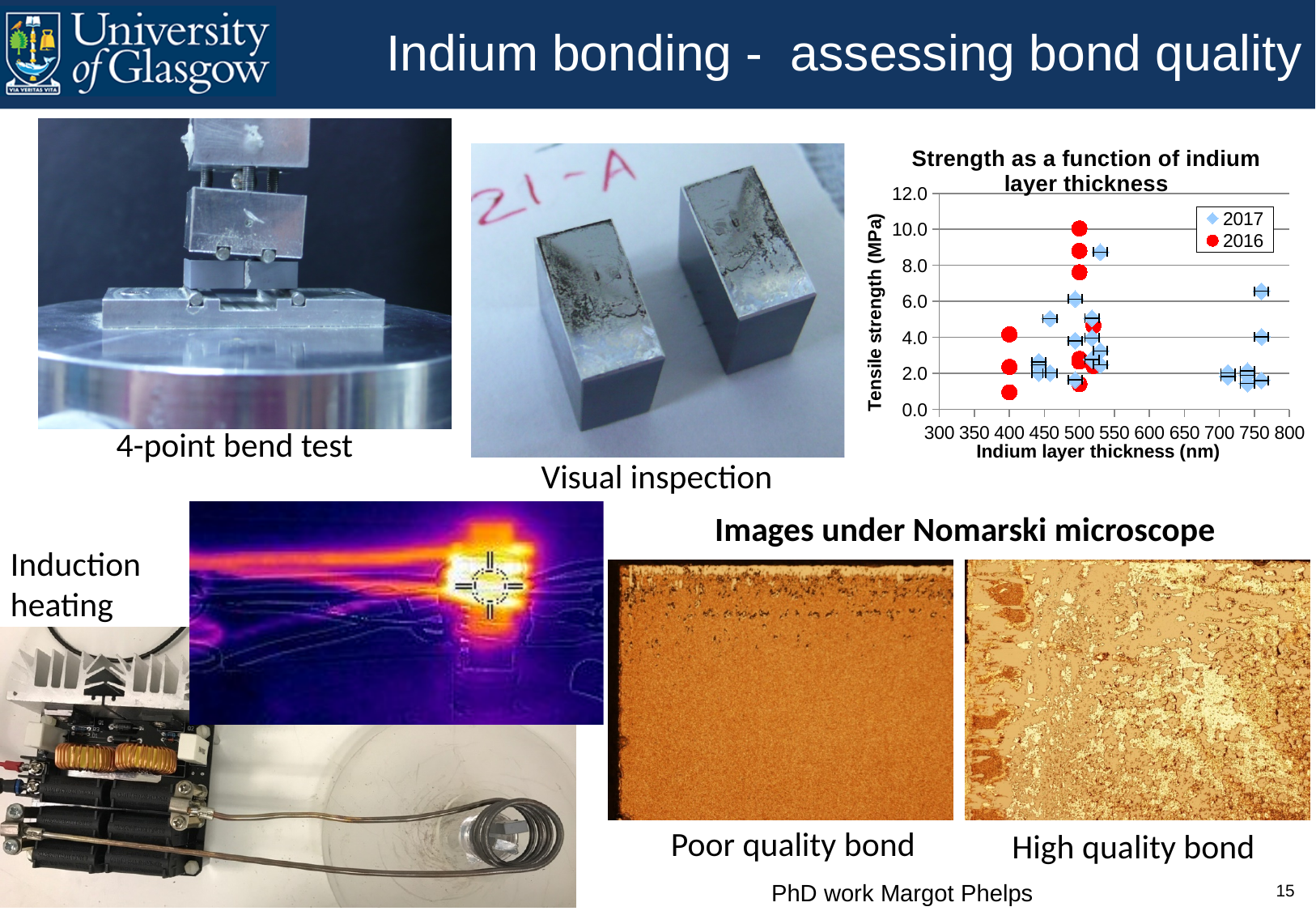
Is the highest tensile strength value for the 2017 series greater or less than 10.0? less Is the lowest tensile strength value for the 2016 series greater or less than 2.0? less Is the highest tensile strength value for the 2016 series greater or less than 8.0? greater What is the label of the y axis of the chart? Tensile strength (MPa) What is the title of the chart on the slide? Strength as a function of indium layer thickness Which series in the chart contains the point with the highest tensile strength? 2016 How many series does the legend of the chart list? 2 Which series has the point with the highest tensile strength at an indium layer thickness of about 400 nm? 2016 What kind of chart is shown on the slide? scatter plot